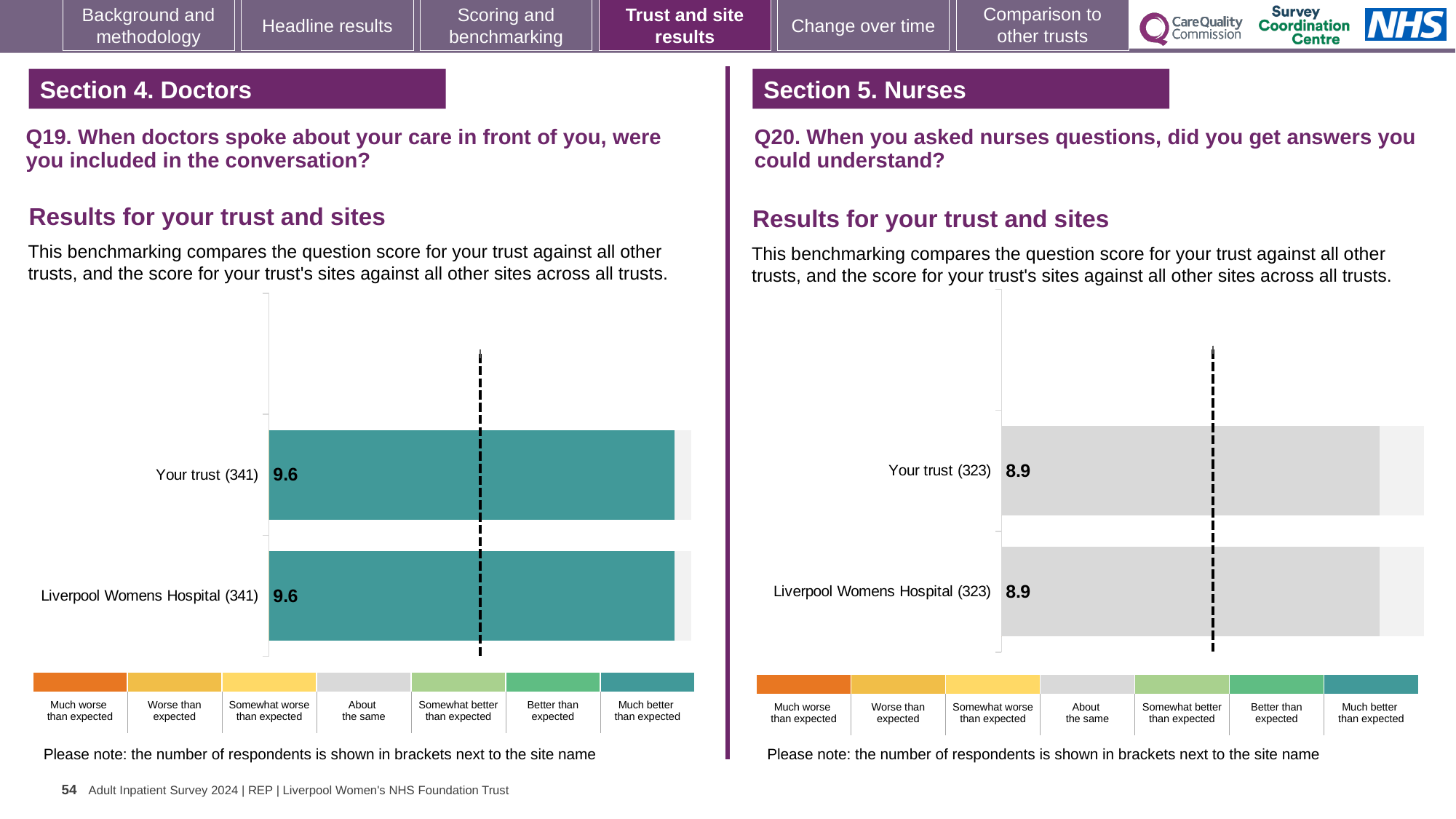
In the Q19 chart on the left, what is the score for Liverpool Womens Hospital? 9.6 How many bars are plotted in the Q20 chart on the right? 2 In the Q19 chart on the left, what is the difference between the Your trust score and the Liverpool Womens Hospital score? 0 In the Q19 chart on the left, what is the score for Your trust? 9.6 In the Q20 chart on the right, what is the difference between the Your trust score and the Liverpool Womens Hospital score? 0 In the Q20 chart on the right, what is the score for Your trust? 8.9 In the Q20 chart on the right, how many respondents are shown in brackets for Liverpool Womens Hospital? 323 In the Q19 chart on the left, how many respondents are shown in brackets for Your trust? 341 How many bars are plotted in the Q19 chart on the left? 2 What type of chart is used for the Q19 results on the left? Bar chart According to the colour key, which benchmark category do the bars in the Q20 chart on the right fall into? About the same In the Q20 chart on the right, what is the score for Liverpool Womens Hospital? 8.9